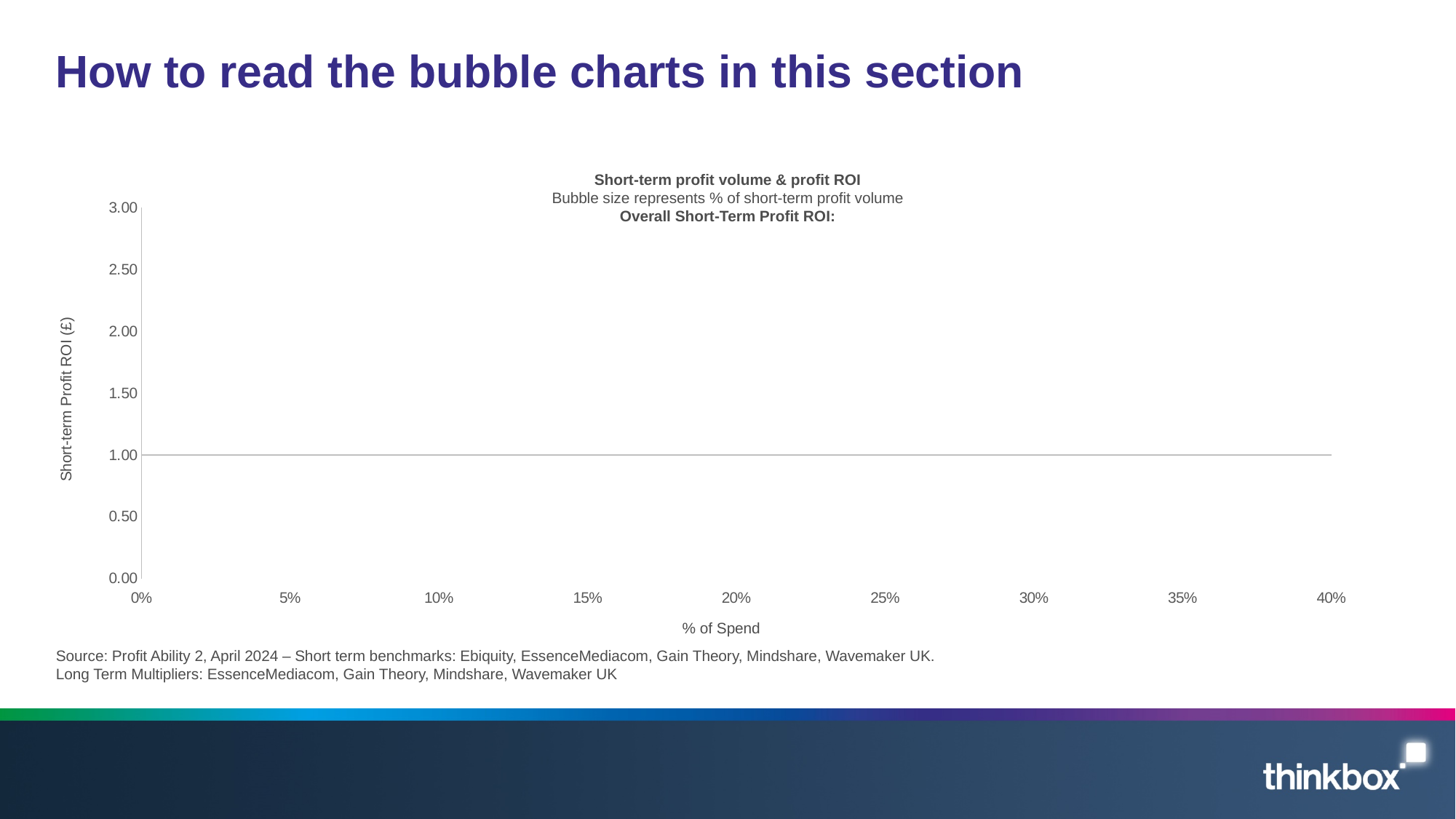
At what y-axis value is the horizontal reference line drawn across the chart? 1.00 What is the highest value shown on the y axis? 3.00 How many bubbles are plotted on the chart? 0 What is the label of the x axis? % of Spend What kind of chart is shown on the slide? bubble chart What is the title of the chart? Short-term profit volume & profit ROI What is the highest value shown on the x axis? 40%